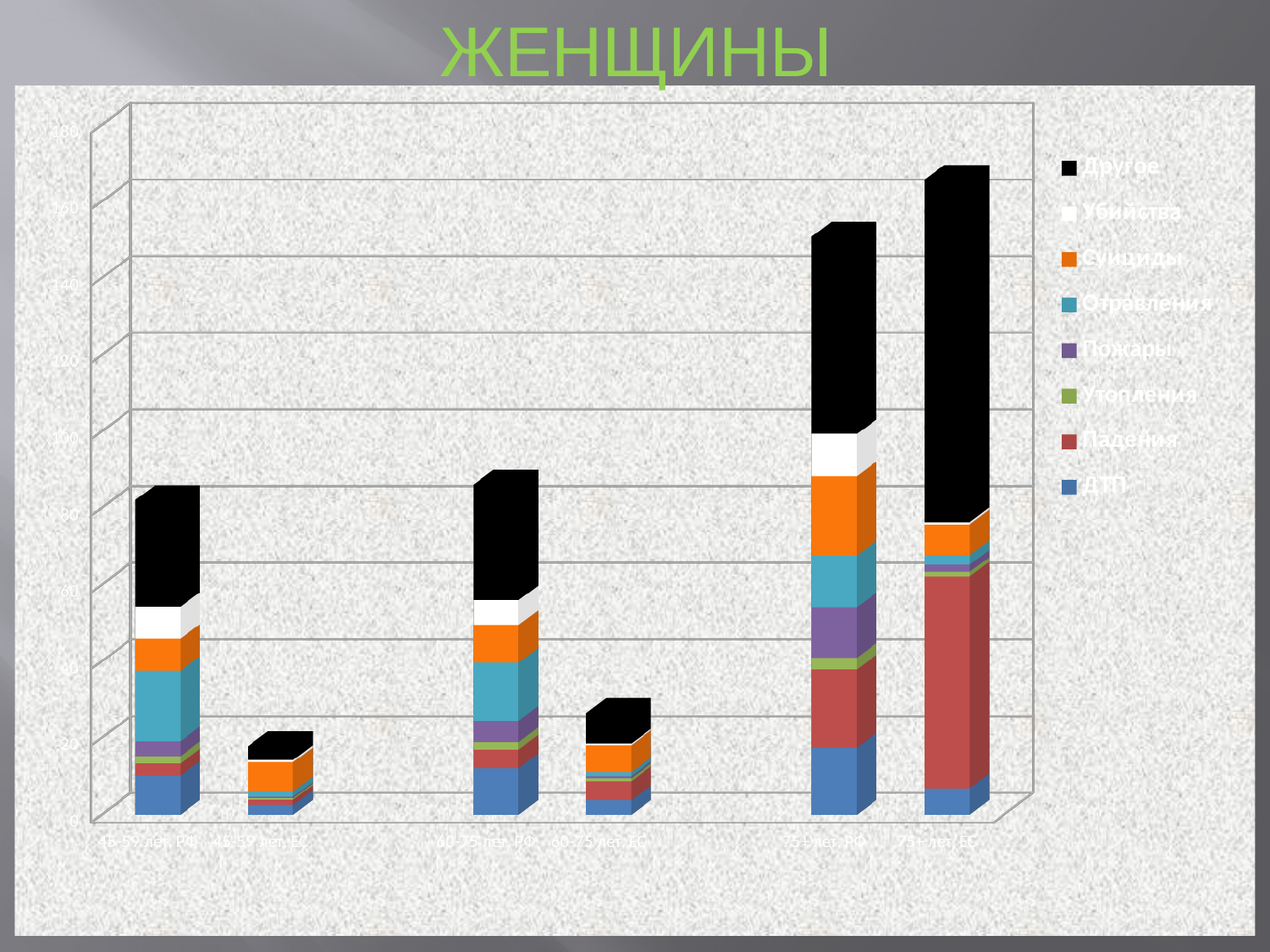
Which colour represents the series 'Другое' in the legend? Black Is the total of the bar for 75+ лет РФ greater or less than 140? greater How many bars (categories) are plotted on the chart? 6 Which category has the tallest stacked bar? 75+ лет ЕС Is the total of the rightmost bar (75+ лет ЕС) greater or less than 160? greater Which category has the shortest stacked bar? 45-59 лет, ЕС How many series does the legend list? 8 What kind of chart is shown on the slide? Stacked bar chart Is the total of the bar for 60-75 лет ЕС greater or less than 40? less What is the title of the slide above the chart? ЖЕНЩИНЫ